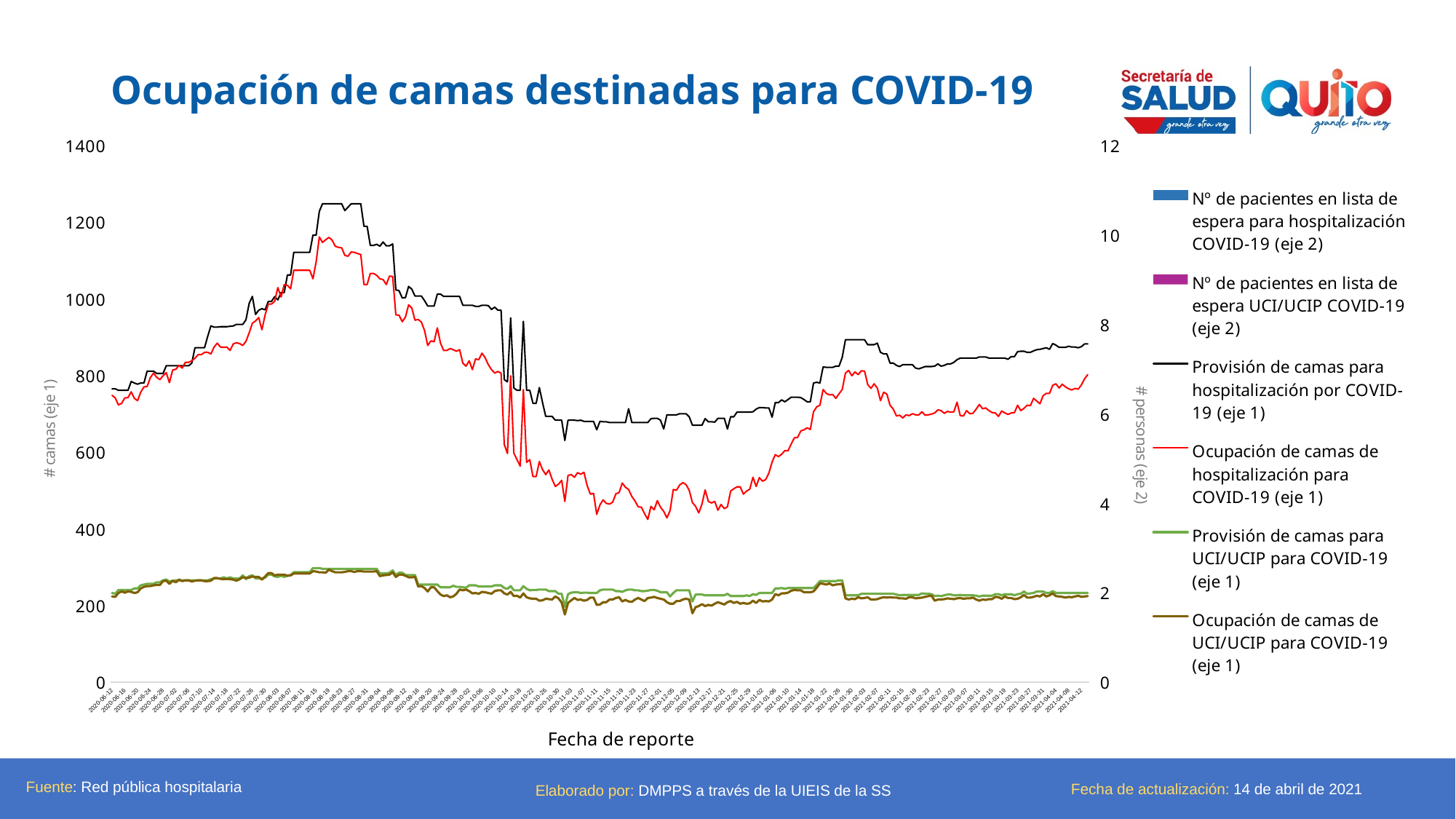
At the last reported date (2021-04-12), which is higher: the 'Provisión de camas para hospitalización por COVID-19' line or the 'Ocupación de camas de hospitalización para COVID-19' line? Provisión de camas para hospitalización por COVID-19 What kind of chart is shown on the slide? line chart Is the peak value of the 'Ocupación de camas de hospitalización para COVID-19 (eje 1)' line greater or less than 1200? less Is the lowest value of the 'Ocupación de camas de hospitalización para COVID-19 (eje 1)' line greater or less than 600? less What is the title of the chart? Ocupación de camas destinadas para COVID-19 Is the peak value of the 'Provisión de camas para hospitalización por COVID-19 (eje 1)' line greater or less than 1200? greater What is the maximum value shown on the right-hand (eje 2) axis? 12 How many series does the legend list? 6 Does the 'Provisión de camas para hospitalización por COVID-19 (eje 1)' line rise or fall between 2020-08-27 and 2020-11-03? fall What is the title of the x axis? Fecha de reporte Does the 'Ocupación de camas de hospitalización para COVID-19 (eje 1)' line rise or fall between 2020-06-12 and 2020-08-19? rise